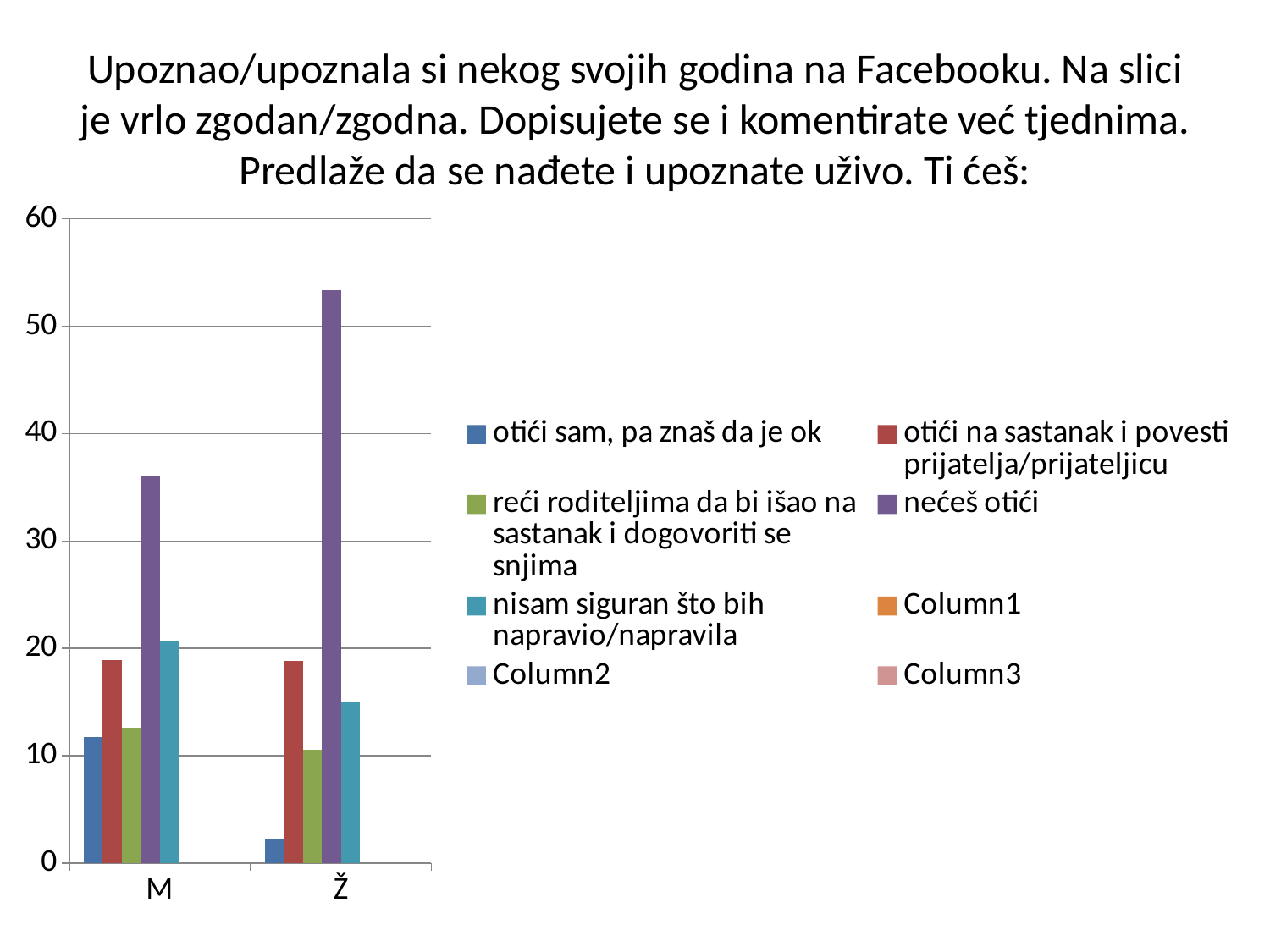
How many categories are shown on the x axis? 2 What colour represents the series 'nećeš otići'? purple Is the value of 'otići sam, pa znaš da je ok' for Ž greater or less than 10? less Is the value of 'nećeš otići' for Ž greater or less than 50? greater Is the value of 'nećeš otići' for M greater or less than 40? less Which series has the highest value for category Ž? nećeš otići What kind of chart is shown on the slide? bar chart Which category has the larger value for 'nećeš otići', M or Ž? Ž Which category has the larger value for 'nisam siguran što bih napravio/napravila', M or Ž? M How many series does the legend list? 8 Which series has the highest value for category M? nećeš otići Which series has the lowest value for category Ž? otići sam, pa znaš da je ok